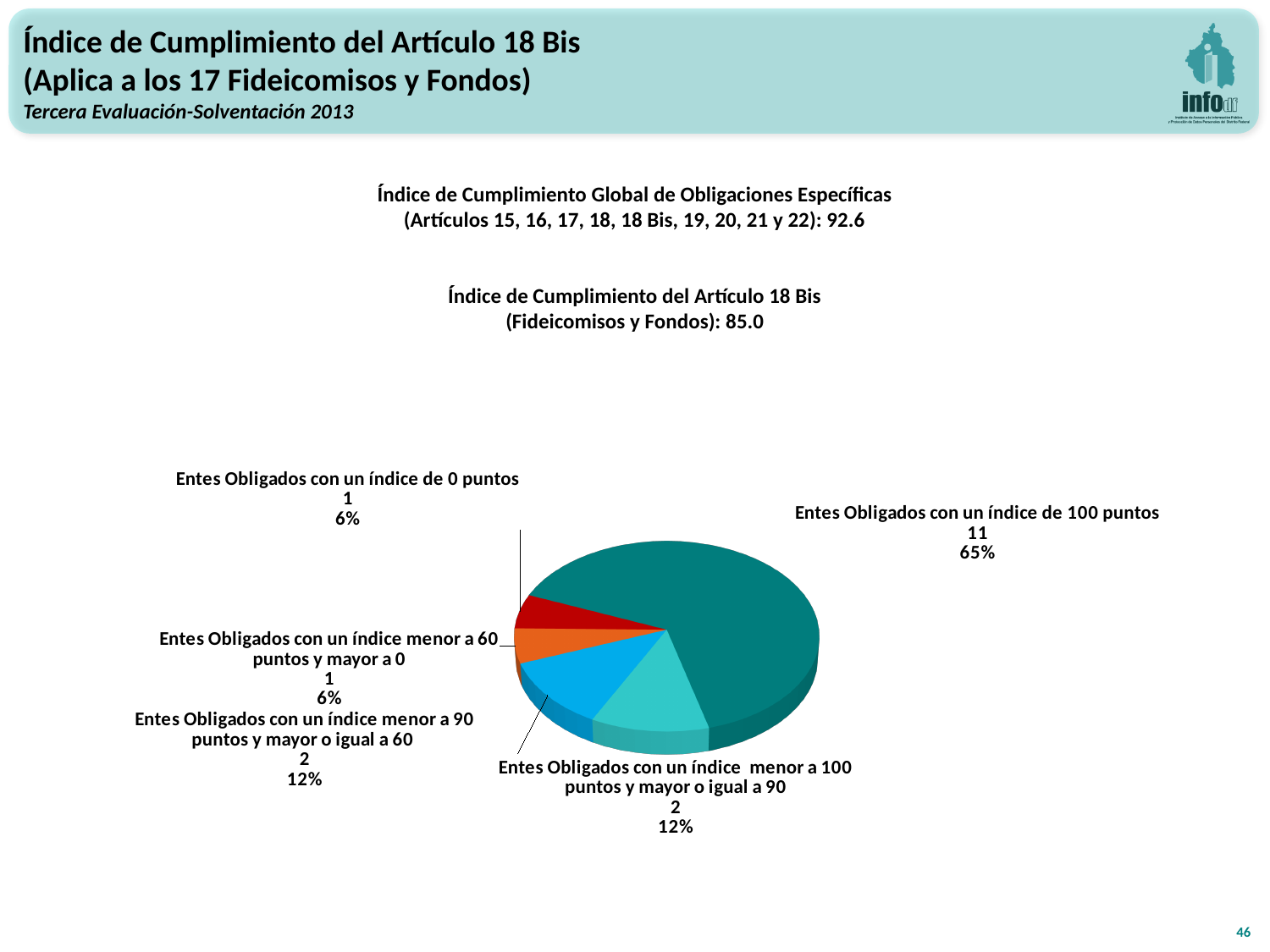
What percentage is shown for Entes Obligados con un índice menor a 60 puntos y mayor a 0? 6% What percentage is shown for Entes Obligados con un índice menor a 90 puntos y mayor o igual a 60? 12% Which is larger: the number of Entes Obligados with an index of 100 points or the number with an index below 100 and at least 90? Entes Obligados con un índice de 100 puntos What is the difference in the number of Entes Obligados between the 100-point category and the 0-point category? 10 How many Entes Obligados have an index below 100 points and greater than or equal to 90? 2 What share of the pie corresponds to Entes Obligados con un índice de 100 puntos? 65% What is the total number of Entes Obligados across all slices of the pie? 17 How many Entes Obligados have an index of 100 points? 11 How many Entes Obligados have an index of 0 points? 1 Which category has the largest slice of the pie? Entes Obligados con un índice de 100 puntos What kind of chart is shown on the slide? pie chart How many slices does the pie chart have? 5